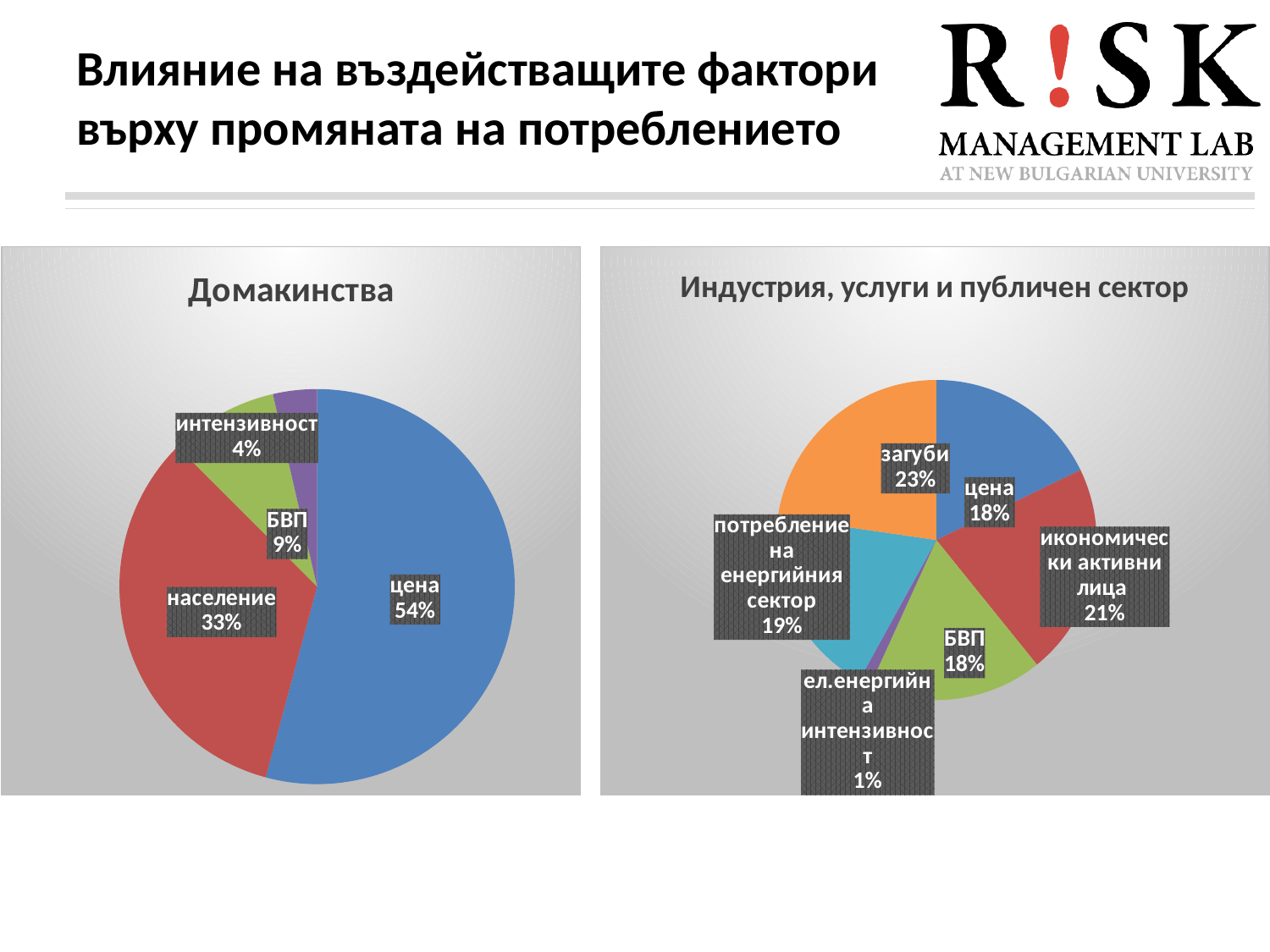
In the 'Индустрия, услуги и публичен сектор' chart, how many slices does the pie have? 6 In the 'Индустрия, услуги и публичен сектор' chart, which category has the largest share? загуби In the 'Домакинства' chart, which category has the smallest share? интензивност In the 'Домакинства' chart, what is the difference in percentage points between 'цена' and 'население'? 21 In the 'Индустрия, услуги и публичен сектор' chart, what share does 'потребление на енергийния сектор' have? 19% In the 'Домакинства' chart, which category has the largest share? цена In the 'Индустрия, услуги и публичен сектор' chart, what share does 'загуби' have? 23% In the 'Домакинства' chart, how many slices does the pie have? 4 What kind of chart is used on the slide? Pie chart In the 'Домакинства' chart, what share does 'население' have? 33% In the 'Домакинства' chart, what share does 'цена' have? 54% In the 'Индустрия, услуги и публичен сектор' chart, which category has the smallest share? ел.енергийна интензивност